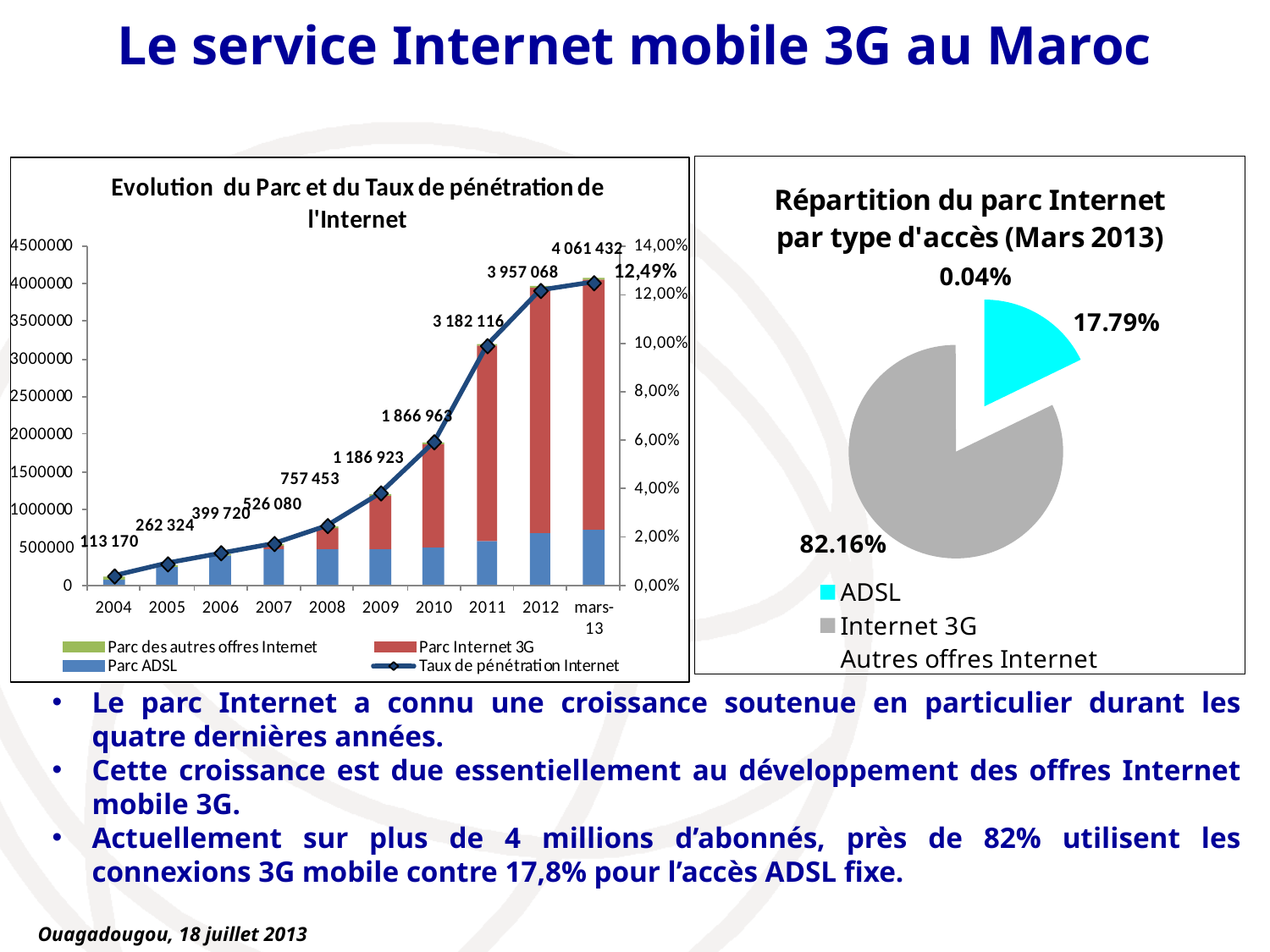
What kind of chart is the right chart 'Répartition du parc Internet par type d'accès (Mars 2013)'? pie chart In the left chart, do the total parc values rise or fall from 2004 to mars-13? rise In the left chart, which period has the highest total parc value? mars-13 In the left chart 'Evolution du Parc et du Taux de pénétration de l'Internet', what is the total parc value labelled for 2012? 3 957 068 In the left chart, what is the Taux de pénétration Internet labelled for mars-13? 12,49% In the left chart, what is the total parc value labelled for mars-13? 4 061 432 In the left chart, how many periods are shown on the x axis? 10 In the left chart, which year has the lowest total parc value? 2004 In the right chart 'Répartition du parc Internet par type d'accès (Mars 2013)', what share does Internet 3G have? 82.16% In the right chart, what share does ADSL have? 17.79% In the left chart, what is the difference between the total parc values labelled for 2012 and 2011? 774 952 In the left chart, how many series does the legend list? 4